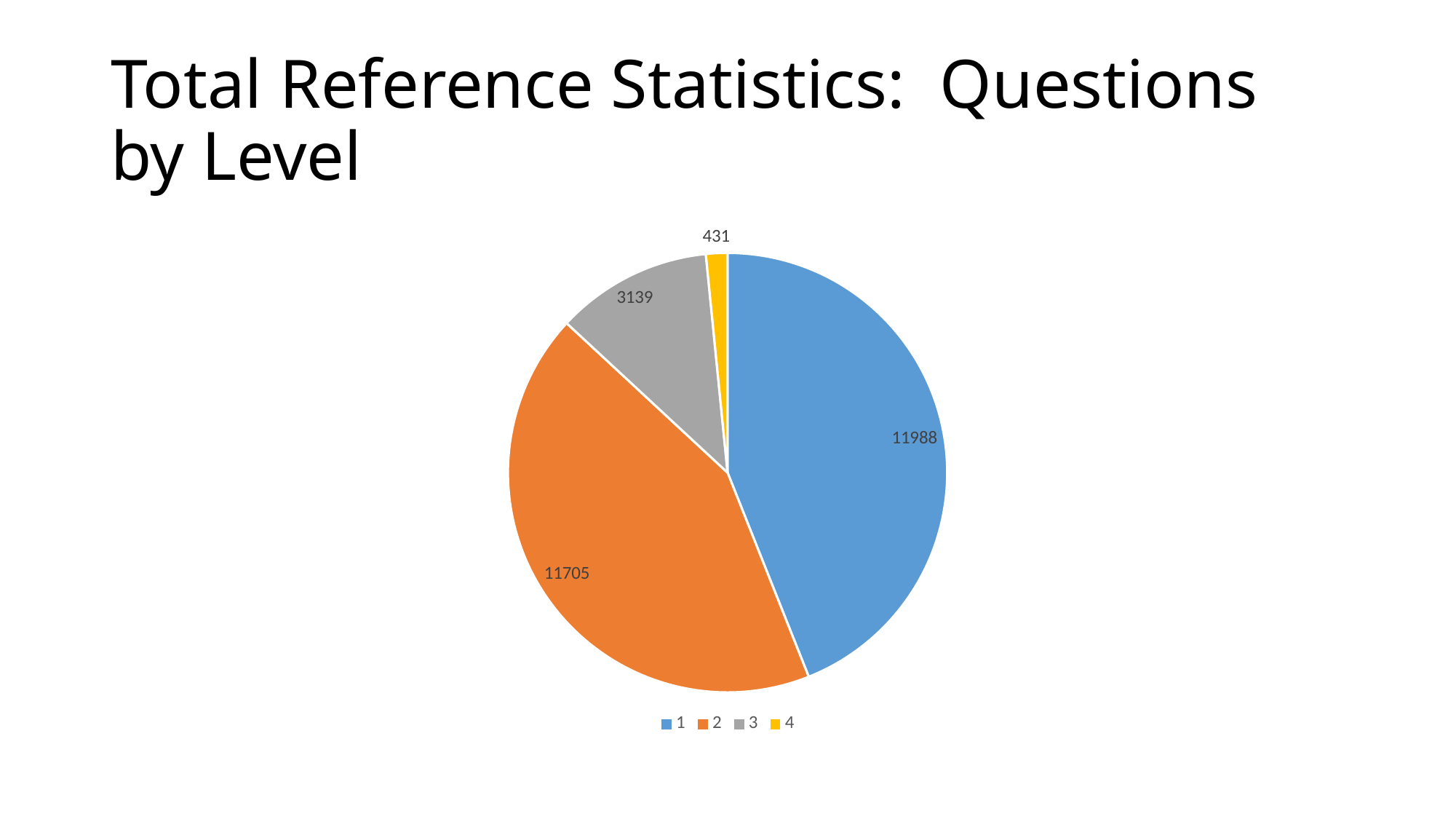
What is the value for level 3 in the pie chart? 3139 What is the value for level 2 in the pie chart? 11705 What is the title of the slide containing the chart? Total Reference Statistics: Questions by Level What is the difference between the values for level 3 and level 4? 2708 Which level has the smallest slice of the pie chart? 4 What kind of chart is shown on the slide? pie chart How many slices does the pie chart have? 4 Which is larger, the value for level 2 or the value for level 3? level 2 What is the value for level 1 in the pie chart? 11988 Which level has the largest slice of the pie chart? 1 What is the difference between the values for level 1 and level 2? 283 What is the value for level 4 in the pie chart? 431